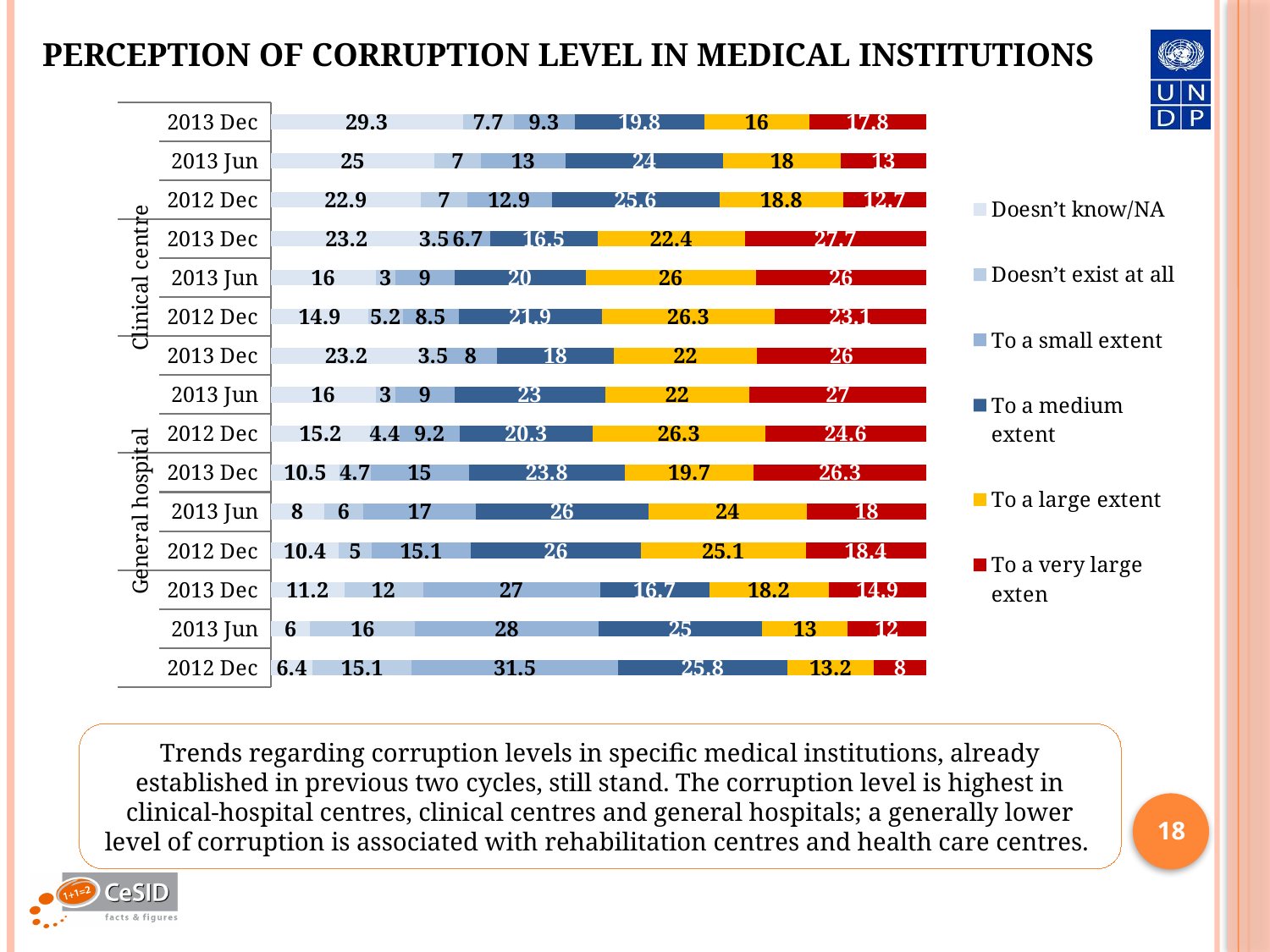
What kind of chart is shown on the slide? Stacked bar chart In the topmost bar (2013 Dec), which is larger: "To a large extent" or "To a very large extent"? To a very large extent In the second bar from the bottom (2013 Jun), what is the value for "To a medium extent"? 25 What is the total of all segments in the bottom bar (2012 Dec)? 100 What colour represents "To a very large extent" in the legend? Red How many bars are plotted in the chart? 15 In the topmost bar (2013 Dec), which response category has the smallest segment? Doesn't exist at all In the bottom bar (2012 Dec), which response category has the largest segment? To a small extent In the bottom bar (2012 Dec), what is the difference between "To a medium extent" and "To a large extent"? 12.6 How many series does the legend list? 6 In the bottom bar (2012 Dec), what is the value for "To a small extent"? 31.5 In the topmost bar (2013 Dec), what is the value for "Doesn't know/NA"? 29.3